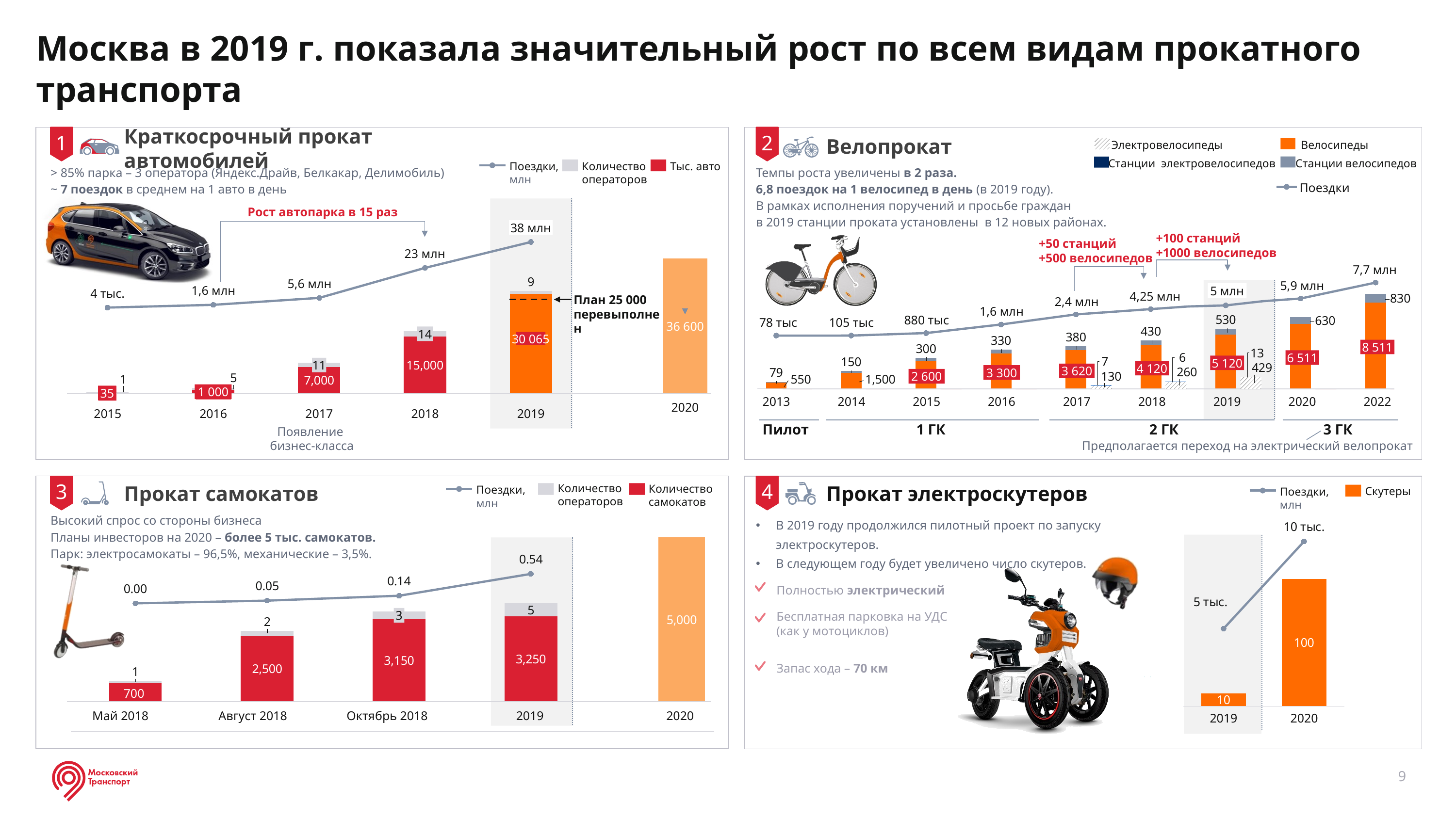
On the "Велопрокат" chart, what is the "Электровелосипеды" value for 2018? 260 On the "Краткосрочный прокат автомобилей" chart, what is the value of the "Тыс. авто" bar for 2018? 15,000 On the "Прокат самокатов" chart, what is the "Количество самокатов" value for Октябрь 2018? 3,150 On the "Прокат электроскутеров" chart, what is the "Скутеры" value for 2020? 100 On the "Велопрокат" chart, which year has the highest "Велосипеды" value? 2022 On the "Прокат самокатов" chart, do the "Поездки, млн" values rise or fall from Май 2018 to 2019? rise On the "Прокат самокатов" chart, what is the difference in "Количество самокатов" between 2019 and Август 2018? 750 On the "Велопрокат" chart, what is the "Велосипеды" value for 2019? 5 120 On the "Краткосрочный прокат автомобилей" chart, how many series does the legend list? 3 On the "Велопрокат" chart, what is the "Поездки" value for 2022? 7,7 млн On the "Краткосрочный прокат автомобилей" chart, how many operators ("Количество операторов") are shown for 2018? 14 On the "Краткосрочный прокат автомобилей" chart, what is the "Поездки, млн" value for 2019? 38 млн